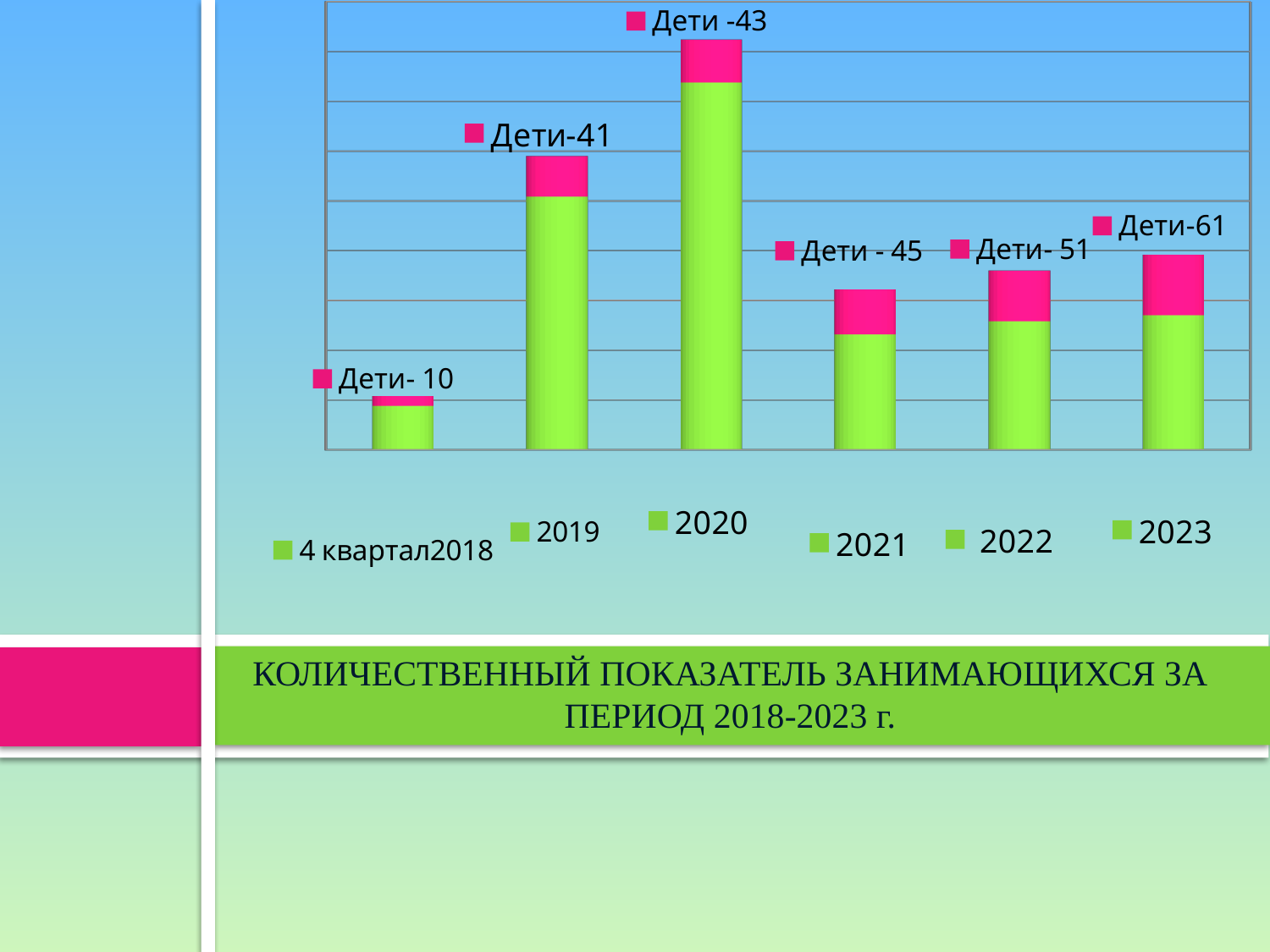
What label is printed above the bar for 4 квартал2018? Дети- 10 What is the title shown beneath the chart? КОЛИЧЕСТВЕННЫЙ ПОКАЗАТЕЛЬ ЗАНИМАЮЩИХСЯ ЗА ПЕРИОД 2018-2023 г. Which bar is taller, the one for 2023 or the one for 4 квартал2018? 2023 What label is printed above the bar for 2020? Дети -43 Which legend entry corresponds to the tallest bar in the chart? 2020 Which bar is taller, the one for 2019 or the one for 2021? 2019 What kind of chart is shown on the slide? bar chart How many bars are plotted in the chart? 6 What label is printed above the bar for 2023? Дети-61 What is the first entry listed in the chart legend? 4 квартал2018 How many entries does the legend list? 6 Which legend entry corresponds to the shortest bar in the chart? 4 квартал2018